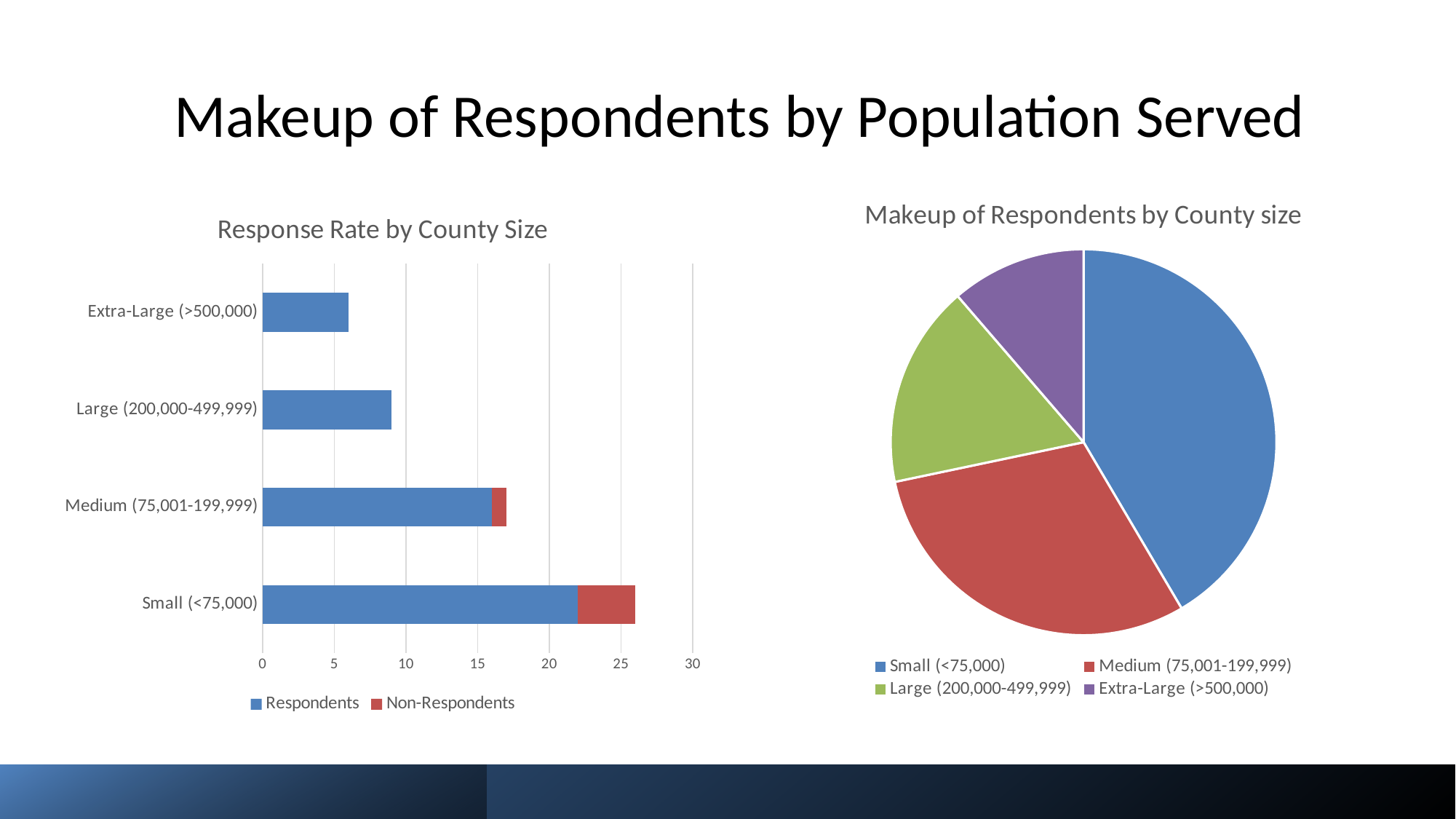
In the 'Makeup of Respondents by County size' pie chart, which county size has the smallest slice? Extra-Large (>500,000) In the 'Response Rate by County Size' chart, which county size has the highest number of Respondents? Small (<75,000) What kind of chart is the 'Makeup of Respondents by County size' chart? pie chart In the 'Response Rate by County Size' chart, which has more Respondents, Medium (75,001-199,999) or Large (200,000-499,999)? Medium (75,001-199,999) In the 'Response Rate by County Size' chart, is the Respondents value for Small (<75,000) greater or less than 20? greater In the 'Makeup of Respondents by County size' pie chart, which county size has the largest slice? Small (<75,000) In the 'Response Rate by County Size' chart, how many county size categories are shown? 4 In the 'Response Rate by County Size' chart, which county size has the lowest number of Respondents? Extra-Large (>500,000) In the 'Makeup of Respondents by County size' pie chart, what colour is the Medium (75,001-199,999) slice? red What kind of chart is the 'Response Rate by County Size' chart? bar chart In the 'Response Rate by County Size' chart, how many series does the legend list? 2 In the 'Response Rate by County Size' chart, is the Respondents value for Large (200,000-499,999) greater or less than 10? less